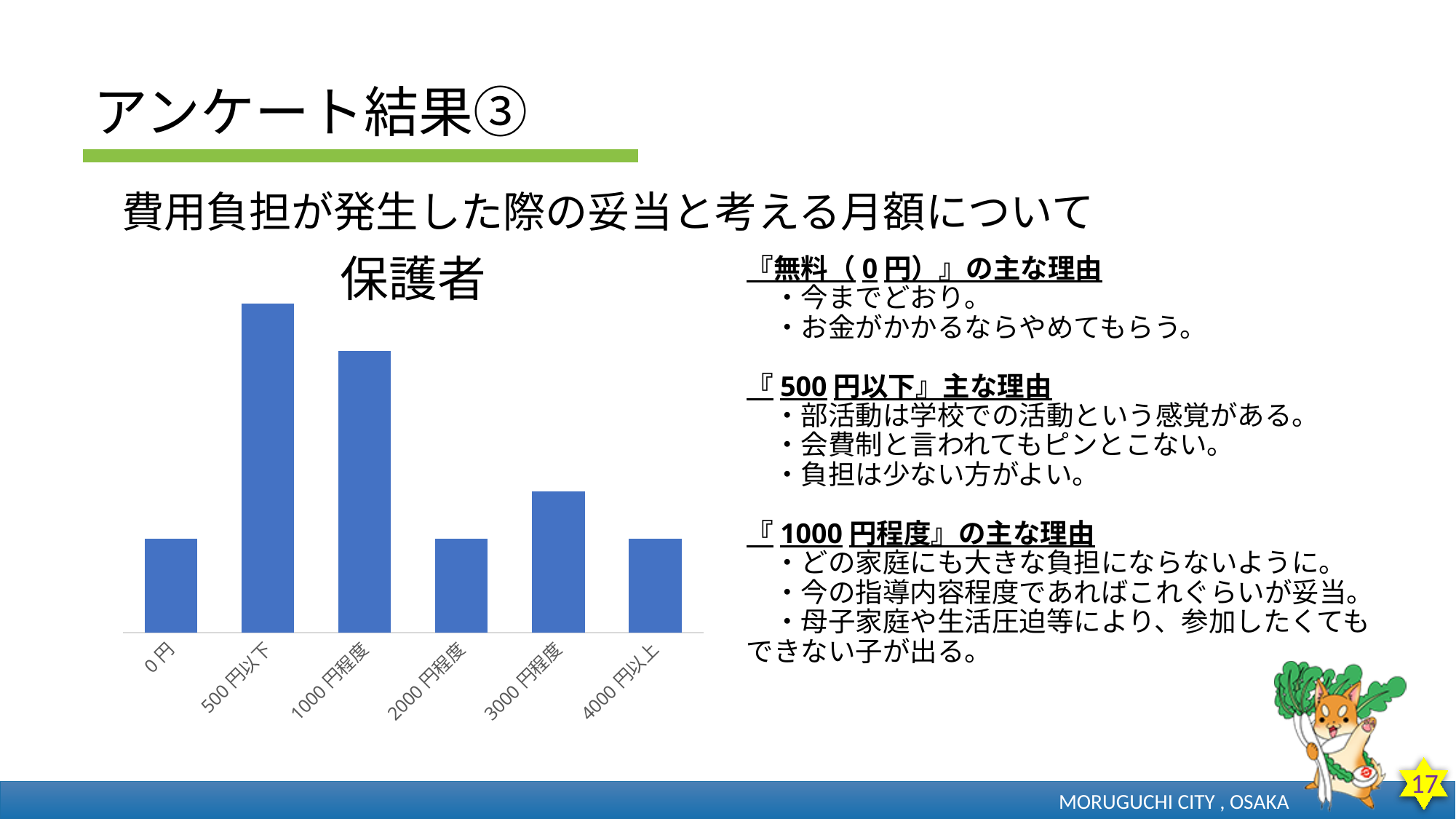
What is the label of the first category on the x axis of the chart? 0 円 What is the label of the last category on the x axis of the chart? 4000 円以上 Which category has the second-highest bar in the chart? 1000 円程度 Which category has the highest bar in the chart? 500 円以下 Which is larger in the chart, the bar for 500 円以下 or the bar for 1000 円程度? 500 円以下 How many categories are shown on the x axis of the chart? 6 What is the title of the chart? 保護者 Which is larger in the chart, the bar for 500 円以下 or the bar for 0 円? 500 円以下 Which is larger in the chart, the bar for 3000 円程度 or the bar for 2000 円程度? 3000 円程度 What kind of chart is shown on the slide? bar chart What colour are the bars in the chart? blue